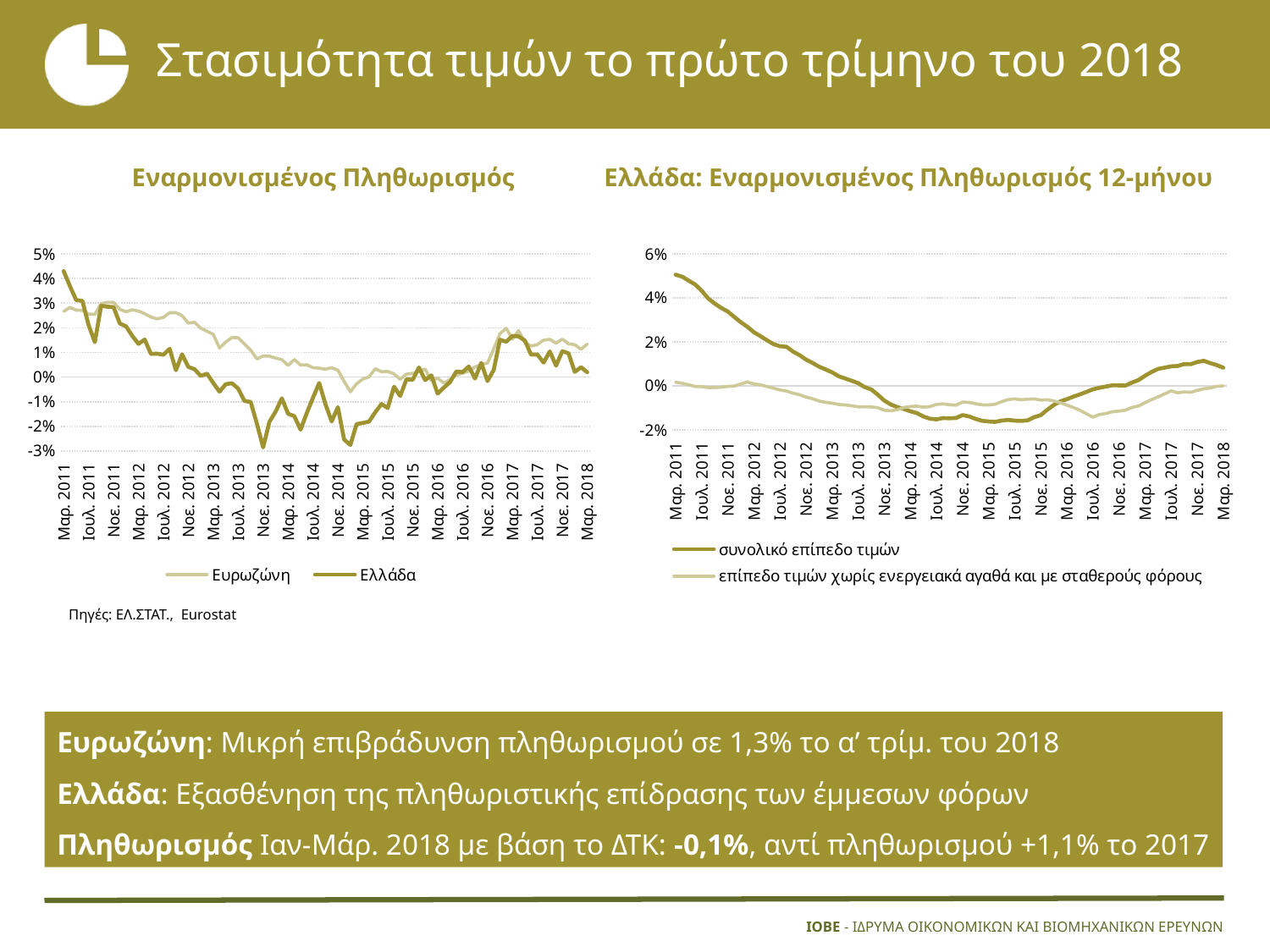
In the left chart 'Εναρμονισμένος Πληθωρισμός', is the value for Ελλάδα in Νοε. 2013 greater or less than -2%? less In the right chart 'Ελλάδα: Εναρμονισμένος Πληθωρισμός 12-μήνου', which series is higher in Μαρ. 2011? συνολικό επίπεδο τιμών In the right chart 'Ελλάδα: Εναρμονισμένος Πληθωρισμός 12-μήνου', is the value for συνολικό επίπεδο τιμών in Μαρ. 2011 greater or less than 4%? greater In the left chart 'Εναρμονισμένος Πληθωρισμός', which series is higher in Μαρ. 2011, Ευρωζώνη or Ελλάδα? Ελλάδα In the left chart 'Εναρμονισμένος Πληθωρισμός', which series is higher in Νοε. 2013, Ευρωζώνη or Ελλάδα? Ευρωζώνη In the left chart 'Εναρμονισμένος Πληθωρισμός', is the value for Ευρωζώνη in Μαρ. 2011 greater or less than 2%? greater In the right chart 'Ελλάδα: Εναρμονισμένος Πληθωρισμός 12-μήνου', does the συνολικό επίπεδο τιμών series rise or fall between Μαρ. 2011 and Μαρ. 2015? fall How many series does the legend of the left chart 'Εναρμονισμένος Πληθωρισμός' list? 2 How many series does the legend of the right chart 'Ελλάδα: Εναρμονισμένος Πληθωρισμός 12-μήνου' list? 2 What kind of chart is the left chart titled 'Εναρμονισμένος Πληθωρισμός'? line chart In the left chart 'Εναρμονισμένος Πληθωρισμός', does the Ελλάδα series rise or fall between Μαρ. 2011 and Νοε. 2013? fall What is the title of the right chart? Ελλάδα: Εναρμονισμένος Πληθωρισμός 12-μήνου